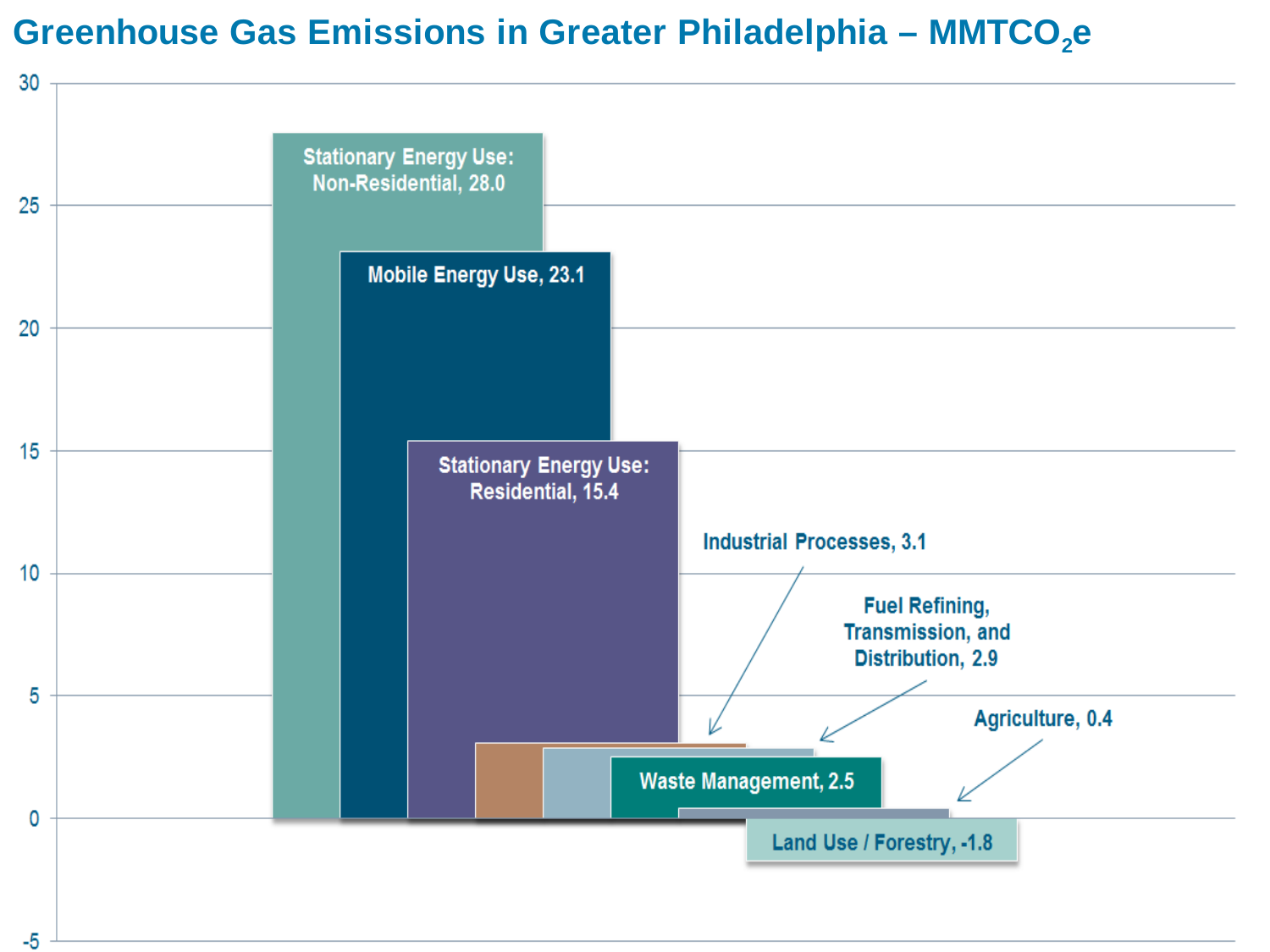
What is the value for Stationary Energy Use: Non-Residential? 28.0 What is the difference between Industrial Processes and Waste Management? 0.6 Which category has the highest emissions? Stationary Energy Use: Non-Residential What is the value for Mobile Energy Use? 23.1 What kind of chart is this? Bar chart What is the value for Fuel Refining, Transmission, and Distribution? 2.9 What is the difference between Stationary Energy Use: Non-Residential and Mobile Energy Use? 4.9 What is the value for Land Use / Forestry? -1.8 How many categories are shown in the chart? 8 Which is larger, Stationary Energy Use: Residential or Mobile Energy Use? Mobile Energy Use Which category has the lowest value? Land Use / Forestry What is the title of the chart? Greenhouse Gas Emissions in Greater Philadelphia – MMTCO2e